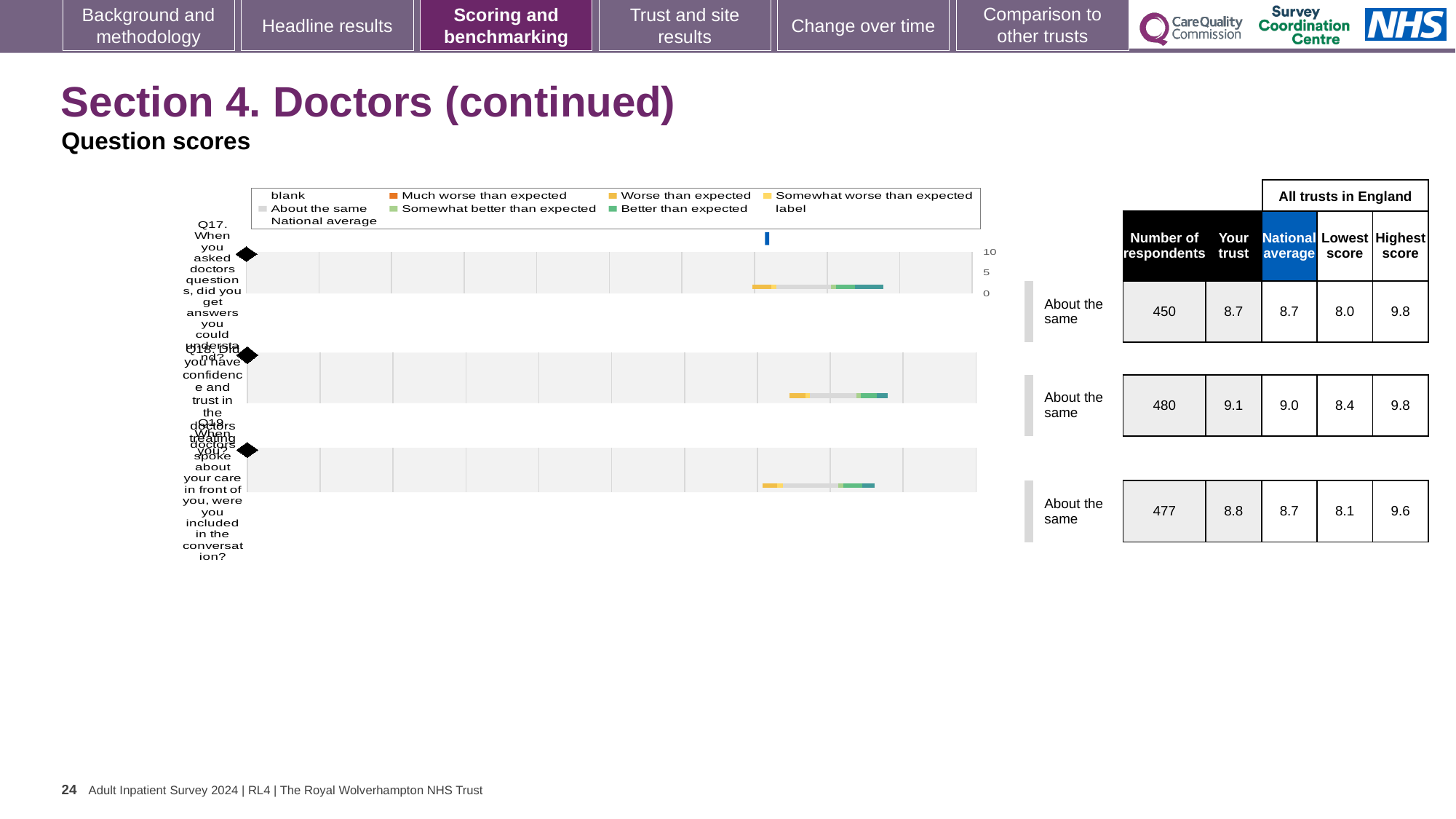
What is the lowest score across all trusts in England for Q19? 8.1 What is the highest score across all trusts in England for Q17? 9.8 Which question has the lowest number of respondents? Q17 What is the 'Your trust' score for Q17? 8.7 What benchmark category is shown for Q18? About the same What is the difference between the 'Your trust' score and the national average for Q18? 0.1 Which question has the highest 'Your trust' score? Q18 What kind of chart is shown on the slide? bar chart What is the 'Your trust' score for Q18? 9.1 For Q19, which is larger: the 'Your trust' score or the national average? Your trust How many questions are plotted in the chart? 3 What is the number of respondents for Q19? 477